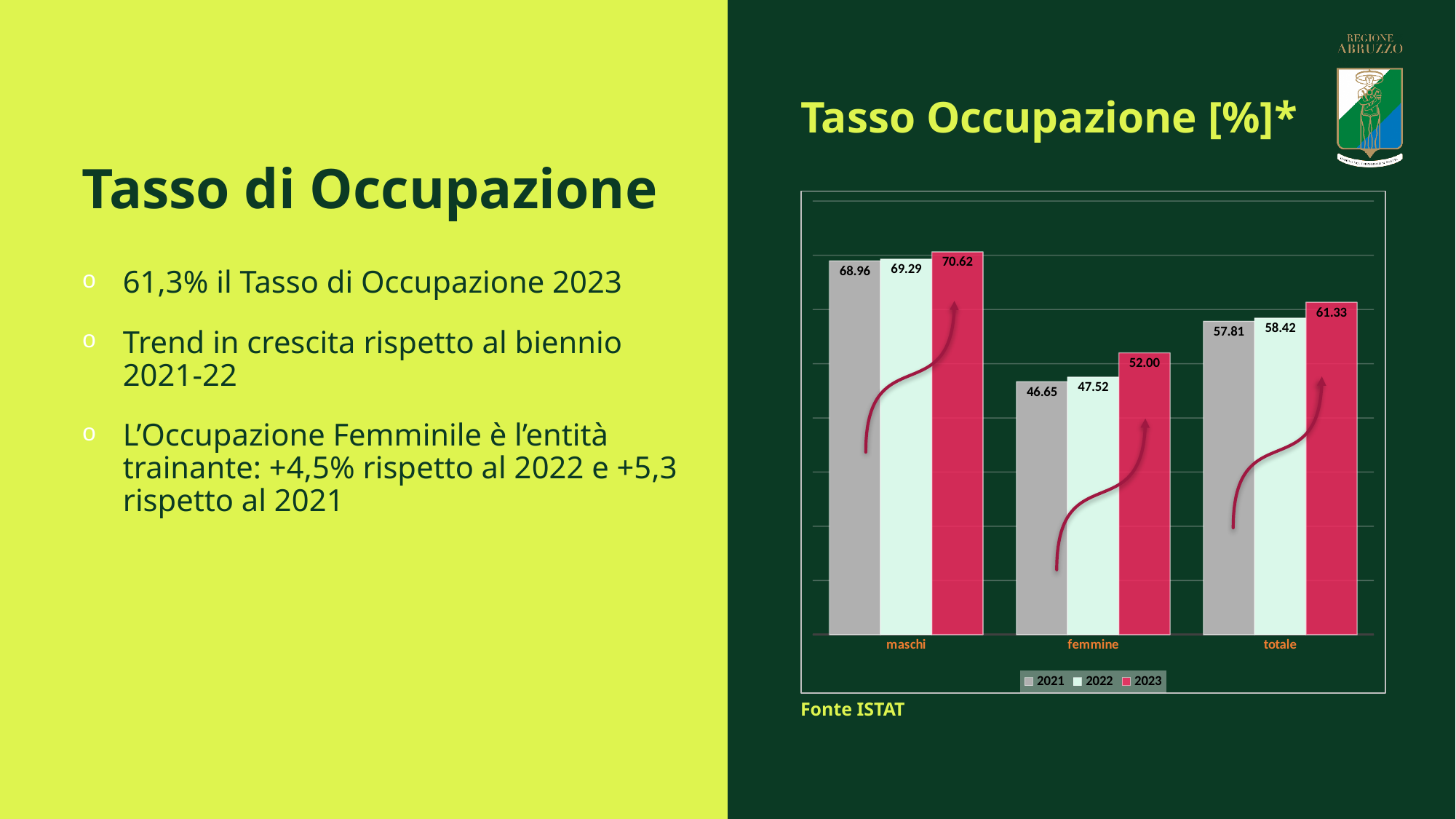
Which category has the lowest value in 2023? femmine What kind of chart is shown? bar chart What is the difference between the 2023 and 2021 values for totale? 3.52 What is the value for maschi in 2023? 70.62 Which is larger: the 2022 value for maschi or the 2023 value for totale? 2022 value for maschi Which category has the highest value in 2021? maschi What is the value for femmine in 2021? 46.65 How many series does the legend list? 3 What is the value for totale in 2022? 58.42 What is the difference between the 2023 and 2022 values for femmine? 4.48 Do the values for femmine rise or fall from 2021 to 2023? rise How many categories are shown on the x axis? 3